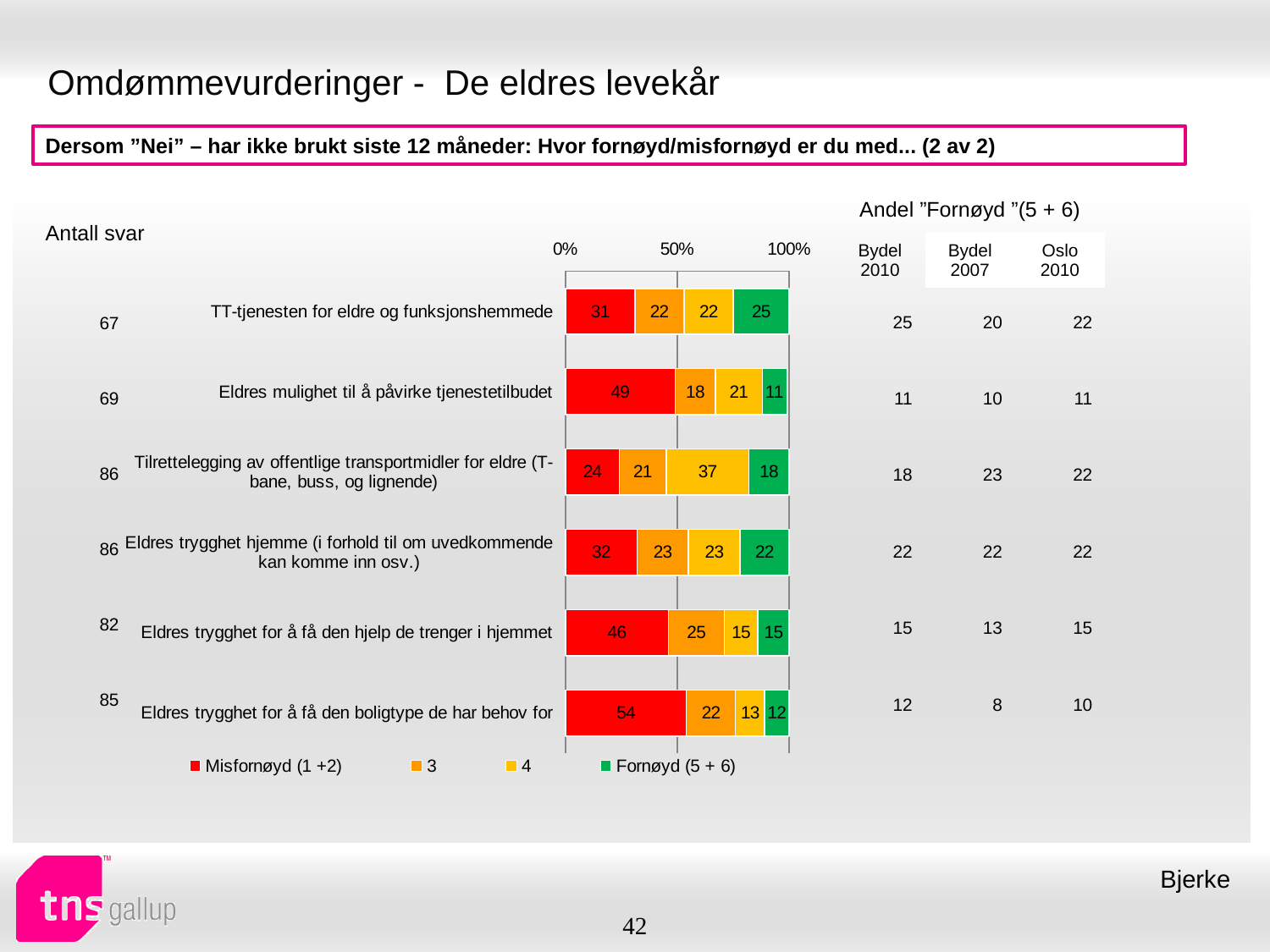
Which category has the lowest Fornøyd (5 + 6) value? Eldres mulighet til å påvirke tjenestetilbudet How many series does the chart legend list? 4 What is the Fornøyd (5 + 6) value for 'TT-tjenesten for eldre og funksjonshemmede'? 25 Which category has the highest Misfornøyd (1 +2) value? Eldres trygghet for å få den boligtype de har behov for What is the value of series '4' for 'Tilrettelegging av offentlige transportmidler for eldre (T-bane, buss, og lignende)'? 37 What type of chart is shown on the slide? stacked bar chart What is the difference between the Misfornøyd (1 +2) values for 'Eldres trygghet for å få den boligtype de har behov for' and 'TT-tjenesten for eldre og funksjonshemmede'? 23 Which is larger: the Fornøyd (5 + 6) value for 'Eldres trygghet hjemme (i forhold til om uvedkommende kan komme inn osv.)' or for 'Eldres trygghet for å få den hjelp de trenger i hjemmet'? Eldres trygghet hjemme (i forhold til om uvedkommende kan komme inn osv.) How many categories (statements) are plotted in the chart? 6 What colour represents the Fornøyd (5 + 6) series in the chart? green What is the total of the stacked bar for 'Eldres mulighet til å påvirke tjenestetilbudet'? 99 What is the Misfornøyd (1 +2) value for 'Eldres trygghet for å få den boligtype de har behov for'? 54